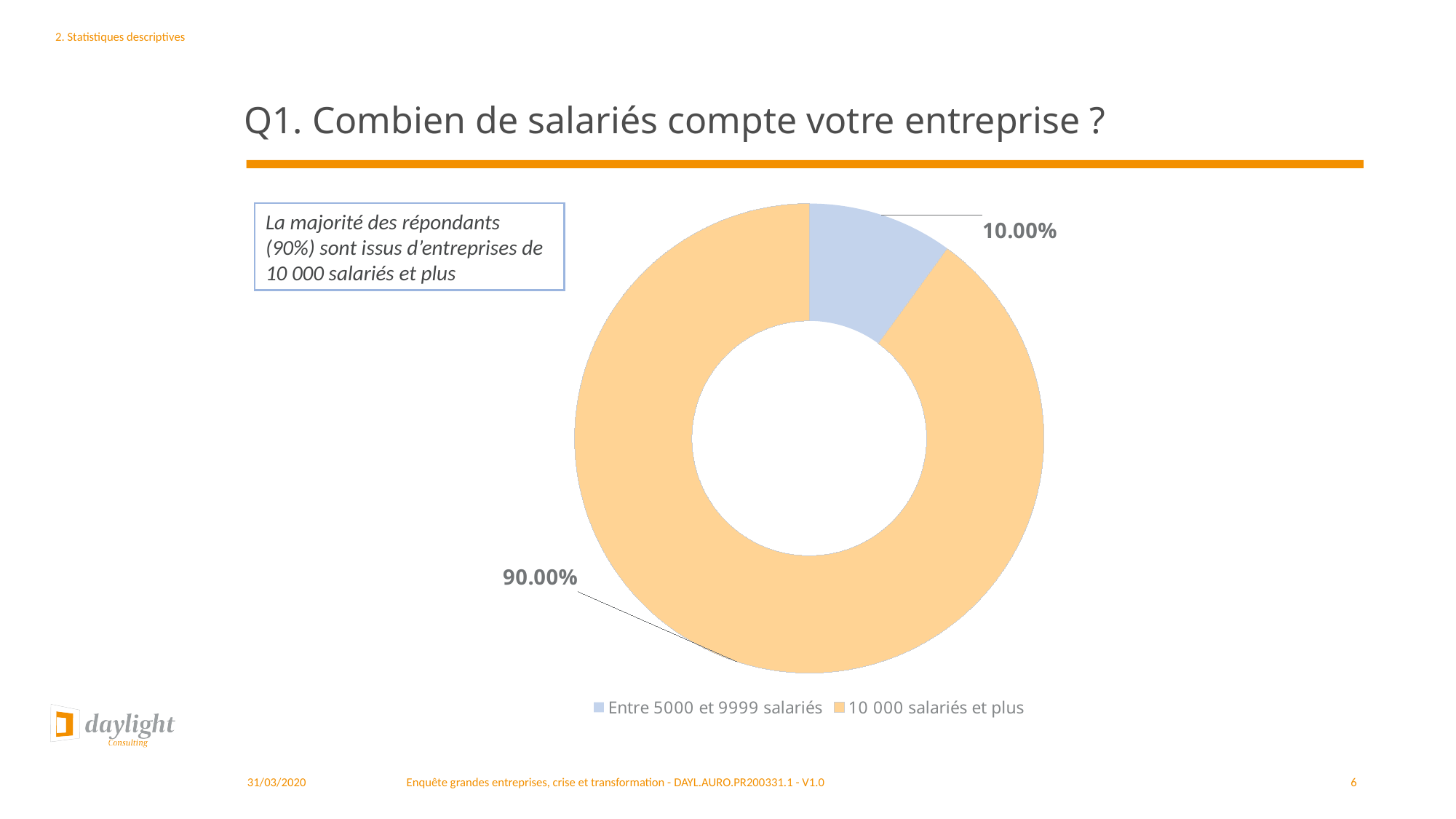
What is the total of the two slices shown in the chart? 100.00% What is the title of the slide containing the chart? Q1. Combien de salariés compte votre entreprise ? Which category has the smallest share of the chart? Entre 5000 et 9999 salariés Which category has the largest share of the chart? 10 000 salariés et plus Which is larger: the share for Entre 5000 et 9999 salariés or the share for 10 000 salariés et plus? 10 000 salariés et plus How many entries does the legend list? 2 What colour is the slice for 10 000 salariés et plus? Orange What percentage of respondents are from companies with 10 000 salariés et plus? 90.00% What percentage of respondents are from companies with Entre 5000 et 9999 salariés? 10.00% What is the difference in percentage points between the share for 10 000 salariés et plus and the share for Entre 5000 et 9999 salariés? 80.00% What kind of chart is shown on the slide? Pie chart (doughnut) How many categories does the chart show? 2